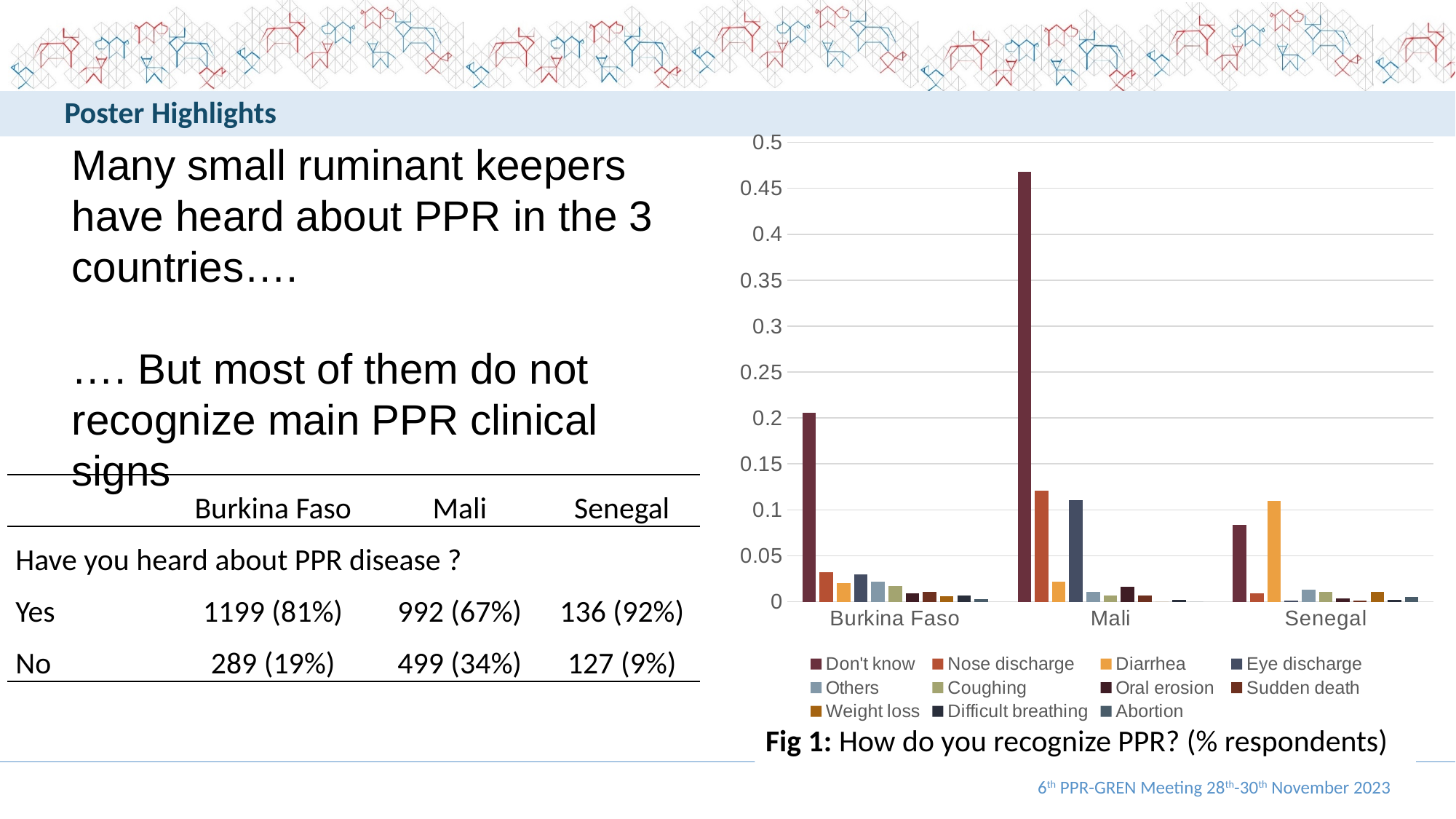
How many series does the legend of the Fig 1 chart list? 11 In the Fig 1 chart, is the 'Diarrhea' value for Senegal greater or less than 0.05? greater In the Fig 1 chart, which country has the highest 'Don't know' value? Mali What kind of chart is Fig 1 on the slide? bar chart In the Fig 1 chart, which series has the tallest bar for Mali? Don't know In the Fig 1 chart, which is larger: the 'Diarrhea' value for Senegal or for Burkina Faso? Senegal In the Fig 1 chart, which series has the tallest bar for Senegal? Diarrhea In the Fig 1 chart, is the 'Don't know' value for Mali greater or less than 0.45? greater In the Fig 1 chart, is the 'Don't know' value for Senegal greater or less than 0.1? less In the Fig 1 chart, which country has the lowest 'Don't know' value? Senegal How many countries are shown on the x axis of the Fig 1 chart? 3 What is the caption of the chart on the slide? Fig 1: How do you recognize PPR? (% respondents)